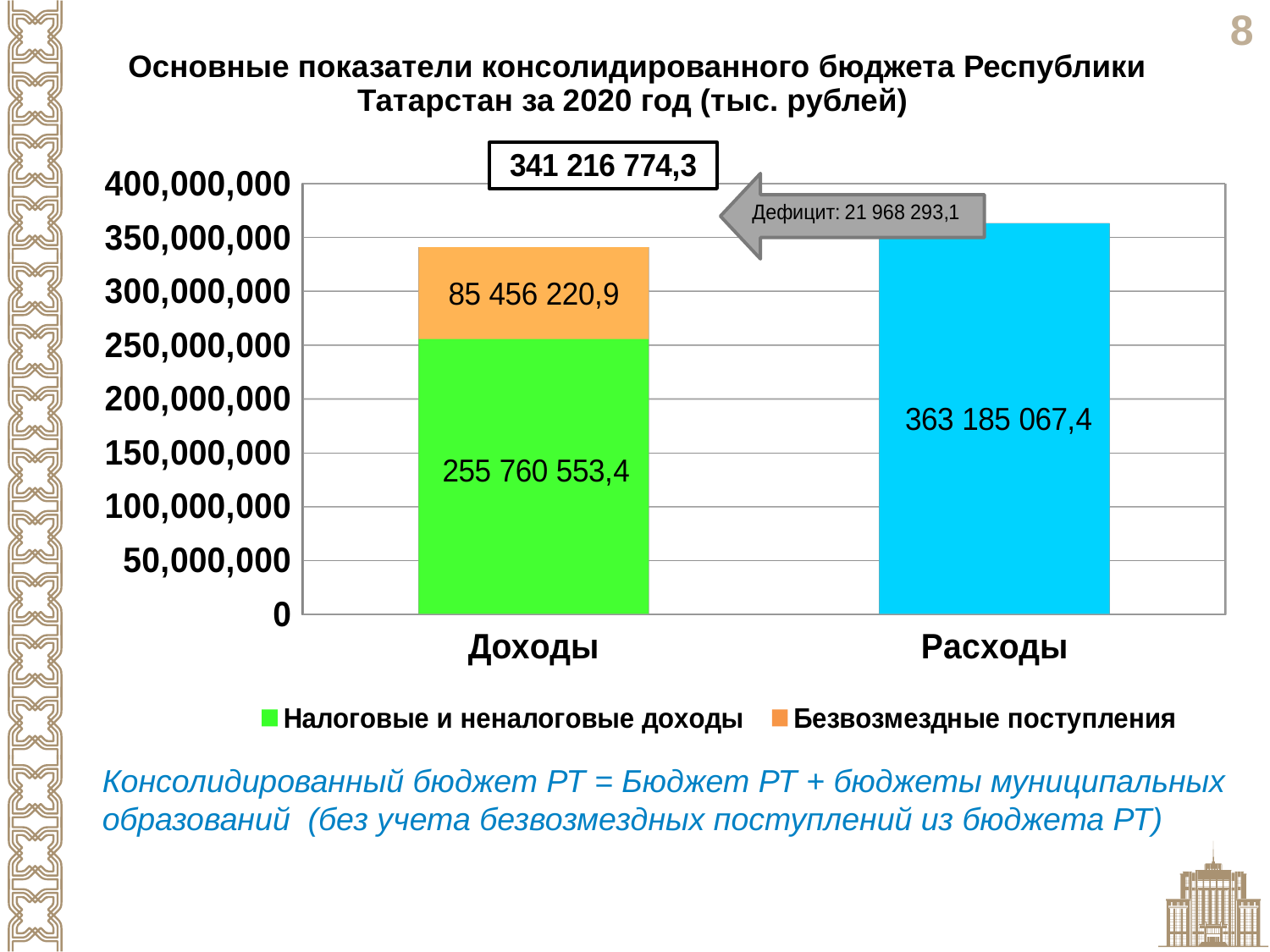
What is the difference between the Налоговые и неналоговые доходы segment and the Безвозмездные поступления segment? 170 304 332,5 How many categories are shown on the x axis? 2 What is the value of the Налоговые и неналоговые доходы segment in the Доходы bar? 255 760 553,4 Which bar is taller, Доходы or Расходы? Расходы What is the value shown for Расходы? 363 185 067,4 How many series does the legend list? 2 What is the value of the Безвозмездные поступления segment in the Доходы bar? 85 456 220,9 Is the value for Расходы greater or less than 350,000,000? greater What is the total of the stacked Доходы bar? 341 216 774,3 What kind of chart is shown on the slide? Stacked bar chart What is the deficit value shown on the chart? 21 968 293,1 What is the difference between Расходы and the total Доходы? 21 968 293,1